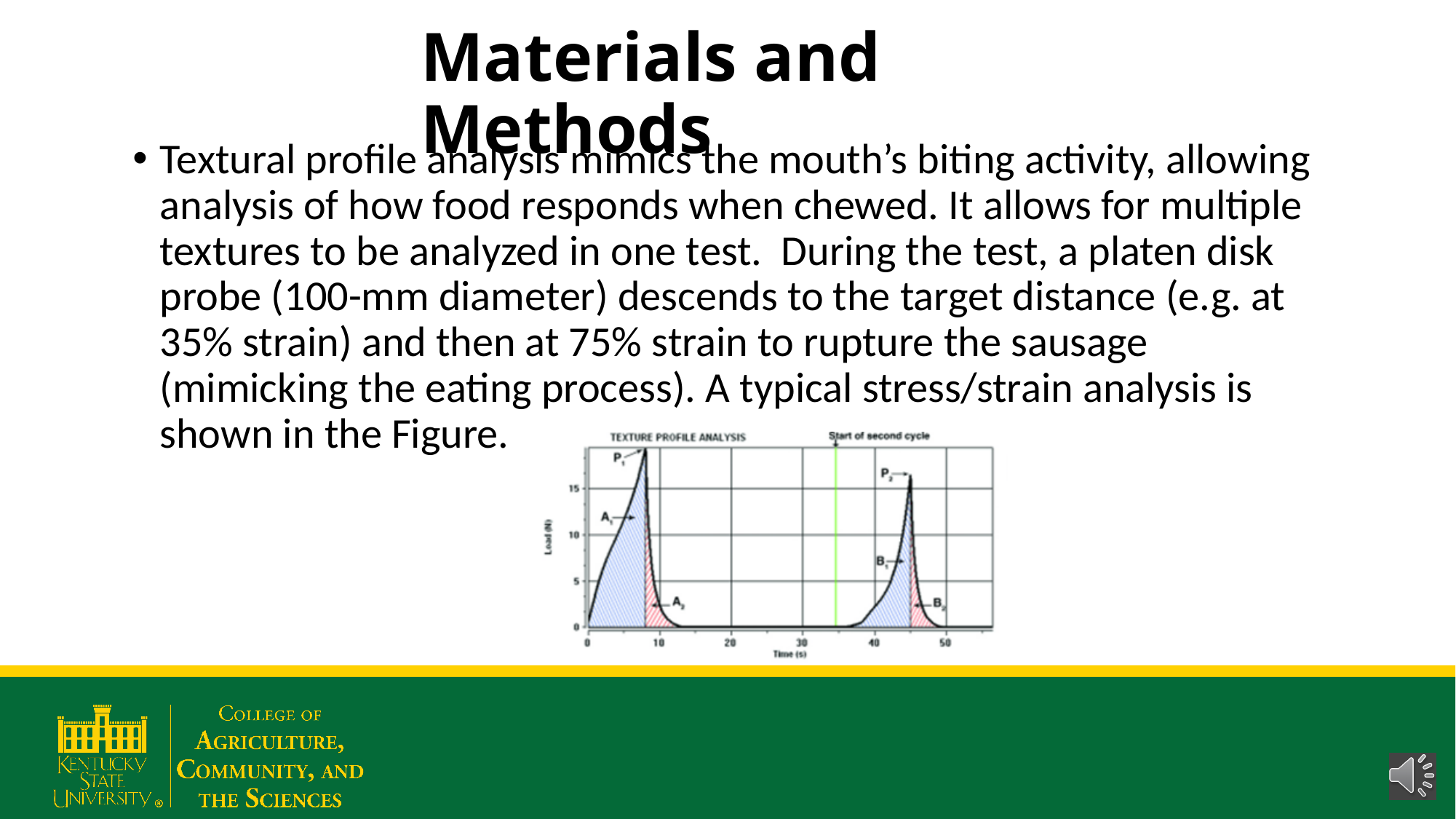
Does the load rise or fall between time 0 and peak P1? rise Which peak is higher on the chart, P1 or P2? P1 How many peaks are labelled on the chart? 2 Is the load at peak P2 greater or less than 10? greater Is the load at peak P1 greater or less than 10? greater Is the load at peak P1 greater or less than 15? greater What is the title printed on the chart? TEXTURE PROFILE ANALYSIS What kind of chart is shown on the slide? line chart Does the load rise or fall between peak P2 and time 50 s? fall What is the highest tick value shown on the time axis? 50 What is the label of the vertical axis of the chart? Load (N)